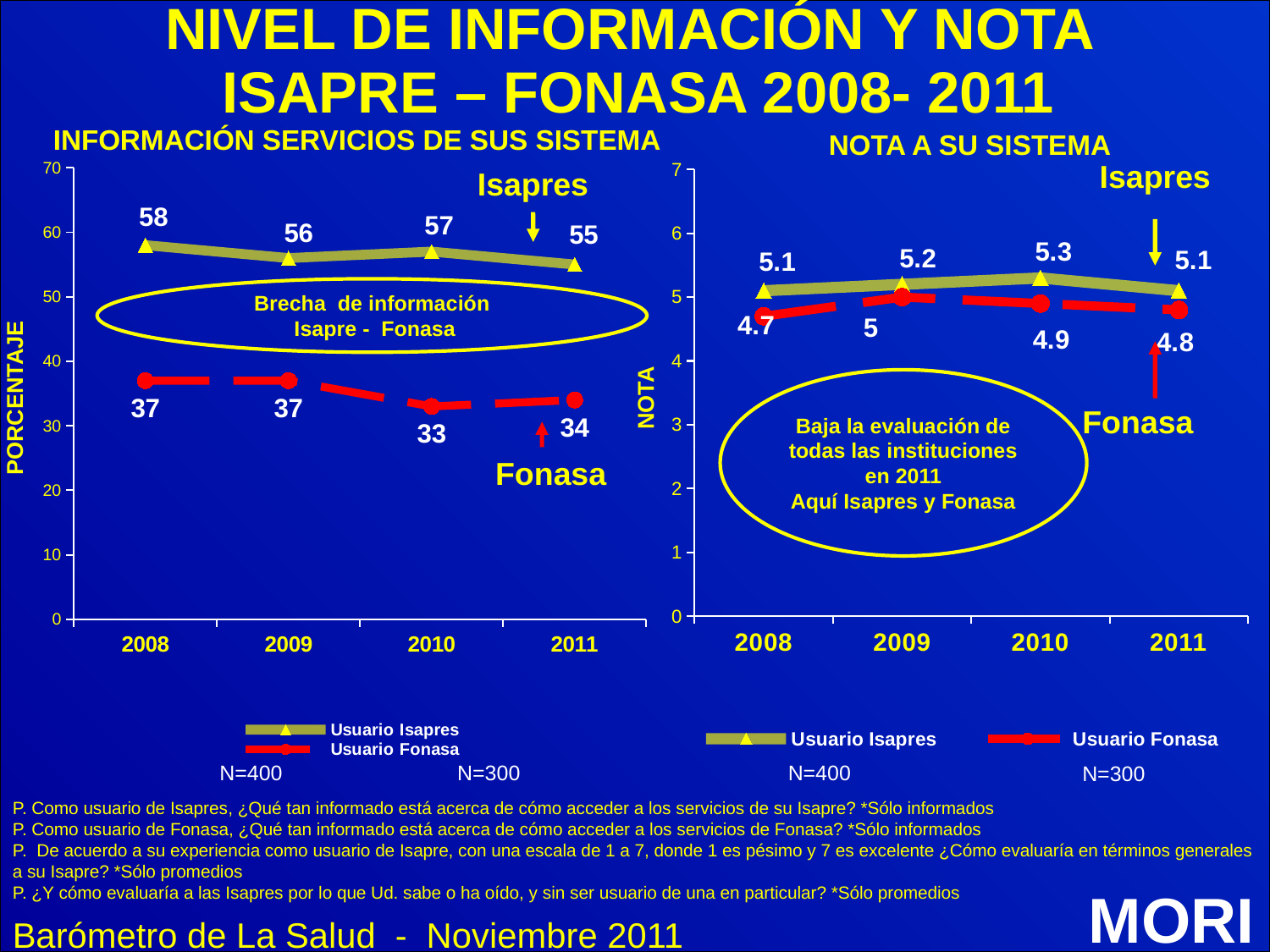
In the 'NOTA A SU SISTEMA' chart, how many series does the legend list? 2 What kind of chart is the 'NOTA A SU SISTEMA' chart? Line chart In the 'NOTA A SU SISTEMA' chart, what is the value for Usuario Fonasa in 2008? 4.7 In the 'INFORMACIÓN SERVICIOS DE SUS SISTEMA' chart, what is the value for Usuario Isapres in 2008? 58 In the 'INFORMACIÓN SERVICIOS DE SUS SISTEMA' chart, in which year is the Usuario Isapres value highest? 2008 In the 'NOTA A SU SISTEMA' chart, what is the value for Usuario Isapres in 2010? 5.3 In the 'INFORMACIÓN SERVICIOS DE SUS SISTEMA' chart, in which year is the Usuario Fonasa value lowest? 2010 In the 'NOTA A SU SISTEMA' chart, what is the difference between Usuario Isapres and Usuario Fonasa in 2009? 0.2 In the 'NOTA A SU SISTEMA' chart, which series has the larger value in 2011, Usuario Isapres or Usuario Fonasa? Usuario Isapres In the 'INFORMACIÓN SERVICIOS DE SUS SISTEMA' chart, what is the difference between Usuario Isapres and Usuario Fonasa in 2011? 21 In the 'INFORMACIÓN SERVICIOS DE SUS SISTEMA' chart, how many years are shown on the x axis? 4 In the 'INFORMACIÓN SERVICIOS DE SUS SISTEMA' chart, what is the value for Usuario Fonasa in 2010? 33